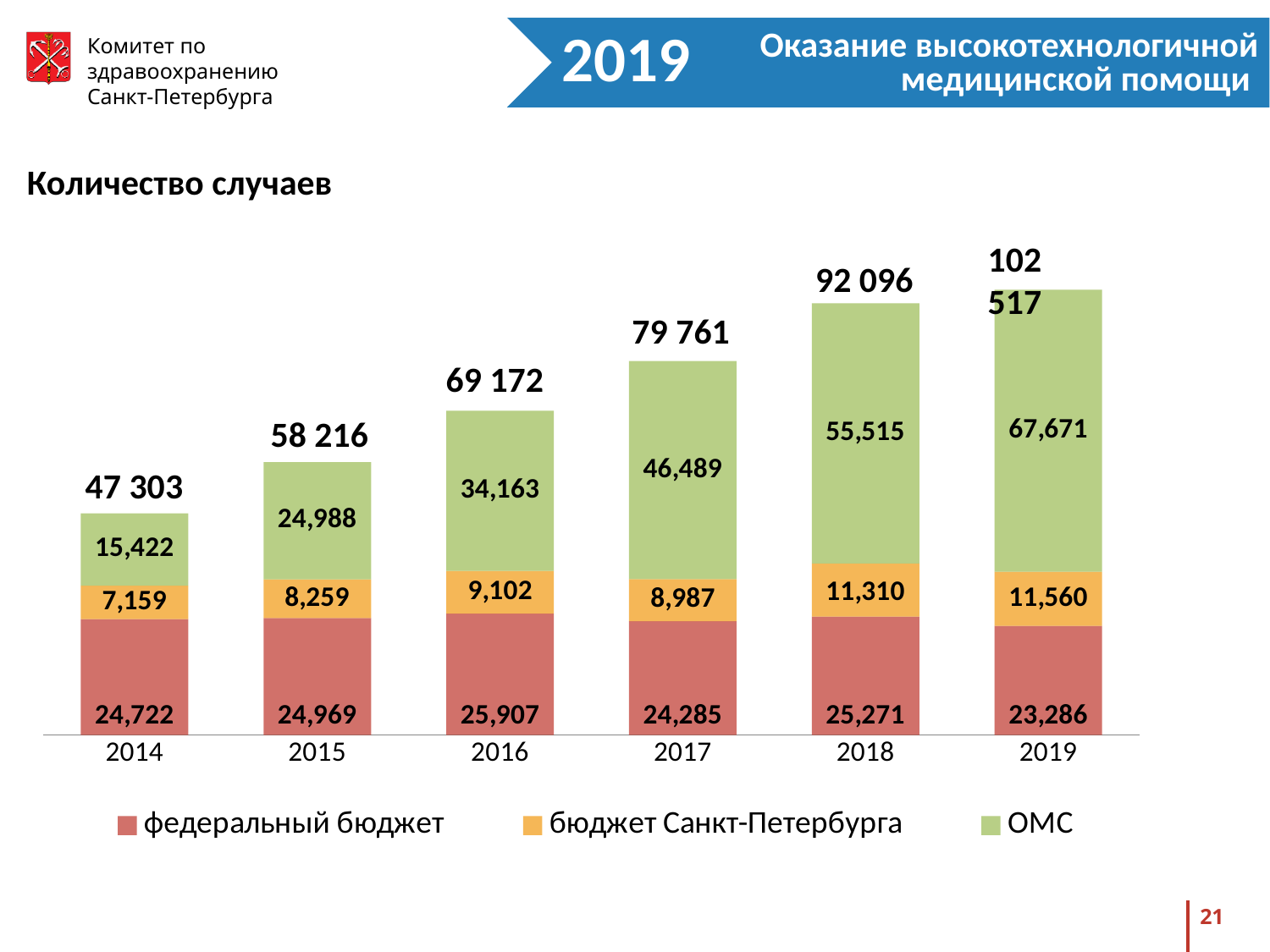
What is the difference between the ОМС value in 2019 and in 2014? 52,249 Which is larger: бюджет Санкт-Петербурга in 2018 or in 2019? 2019 In which year is the федеральный бюджет value lowest? 2019 What is the value for бюджет Санкт-Петербурга in 2014? 7,159 Do the total values rise or fall from 2014 to 2019? Rise What is the value for ОМС in 2016? 34,163 How many years are shown on the x axis? 6 What is the total number of cases shown for 2018? 92 096 In which year is the ОМС value highest? 2019 How many series does the legend list? 3 What kind of chart is shown on the slide? Stacked bar chart What is the value for федеральный бюджет in 2019? 23,286